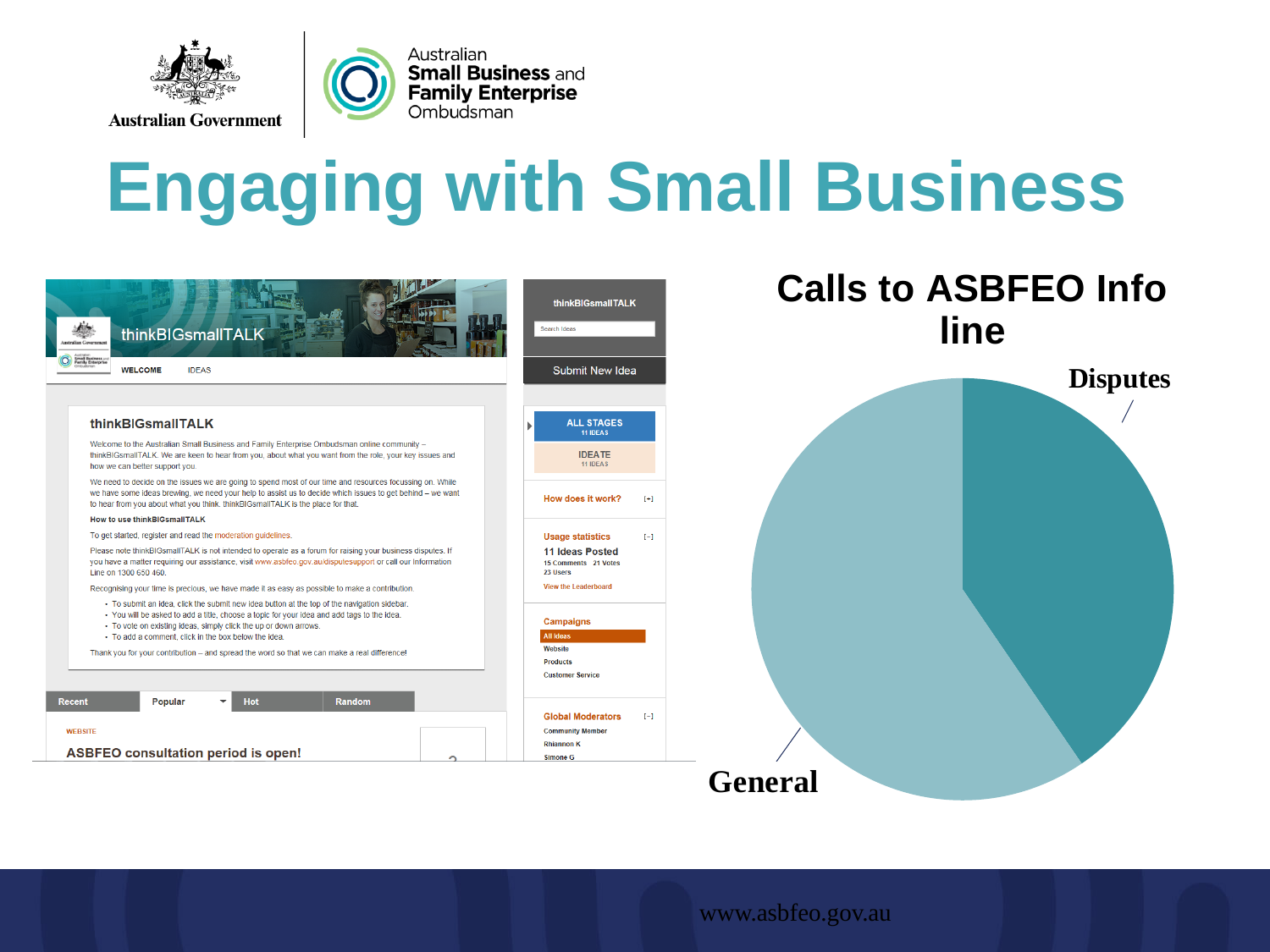
In the "Calls to ASBFEO Info line" pie chart, which slice is larger, Disputes or General? General What are the two categories shown in the "Calls to ASBFEO Info line" pie chart? Disputes and General What is the title of the pie chart on the slide? Calls to ASBFEO Info line Which category has the largest slice in the "Calls to ASBFEO Info line" pie chart? General What kind of chart is the "Calls to ASBFEO Info line" chart? Pie chart Which category has the smallest slice in the "Calls to ASBFEO Info line" pie chart? Disputes How many slices does the "Calls to ASBFEO Info line" pie chart have? 2